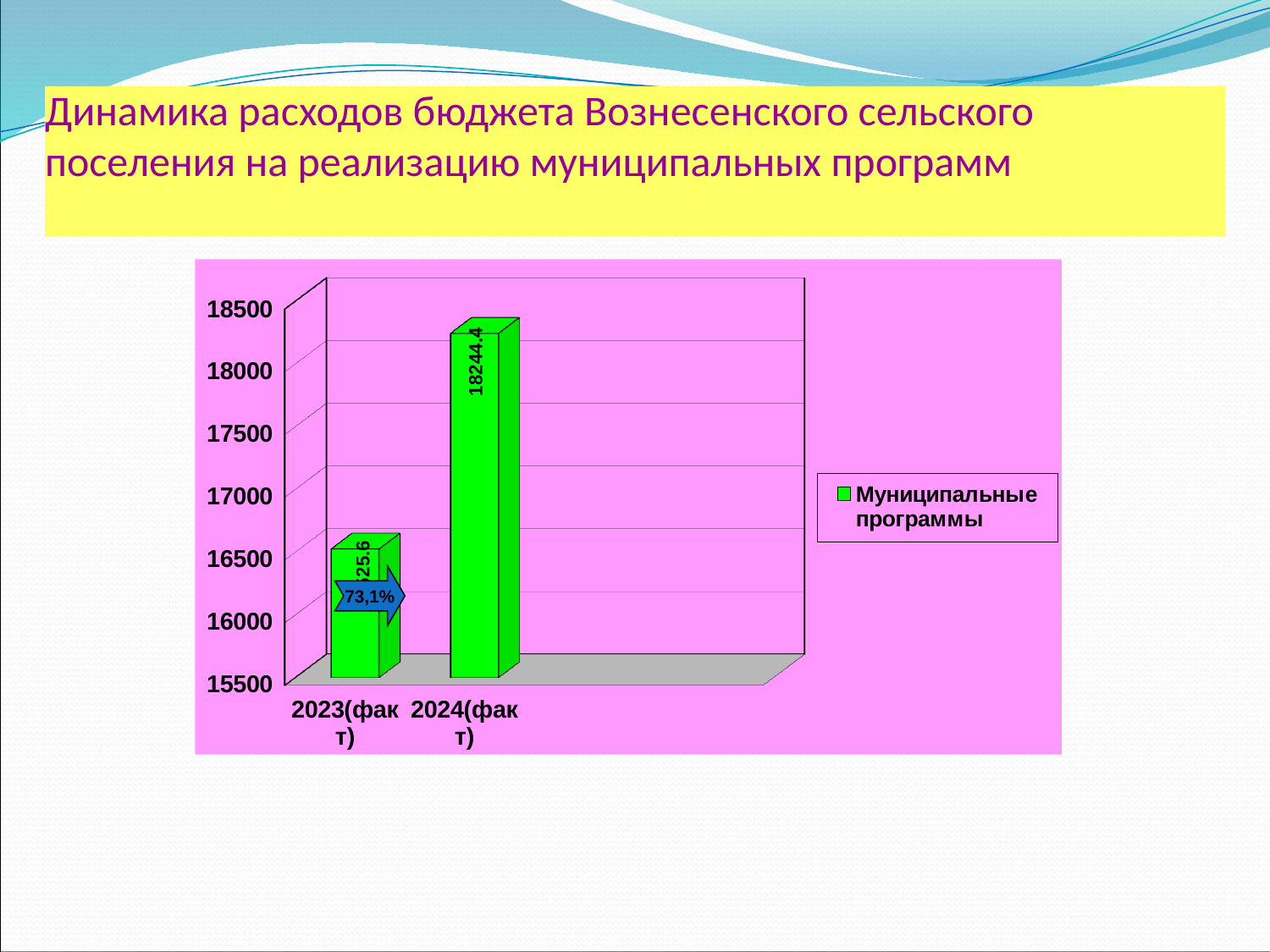
Which is larger, the value for 2023(факт) or 2024(факт)? 2024(факт) Which category has the highest value? 2024(факт) Is the value for 2023(факт) greater or less than 17000? less What series name is shown in the legend? Муниципальные программы What kind of chart is shown on the slide? bar chart Do the values rise or fall from 2023(факт) to 2024(факт)? rise Is the value for 2024(факт) greater or less than 18000? greater What percentage is printed on the blue arrow next to the 2023(факт) bar? 73,1% Which category has the lowest value? 2023(факт) What is the value for 2024(факт)? 18244.4 How many categories are shown on the x axis? 2 How many series does the legend list? 1